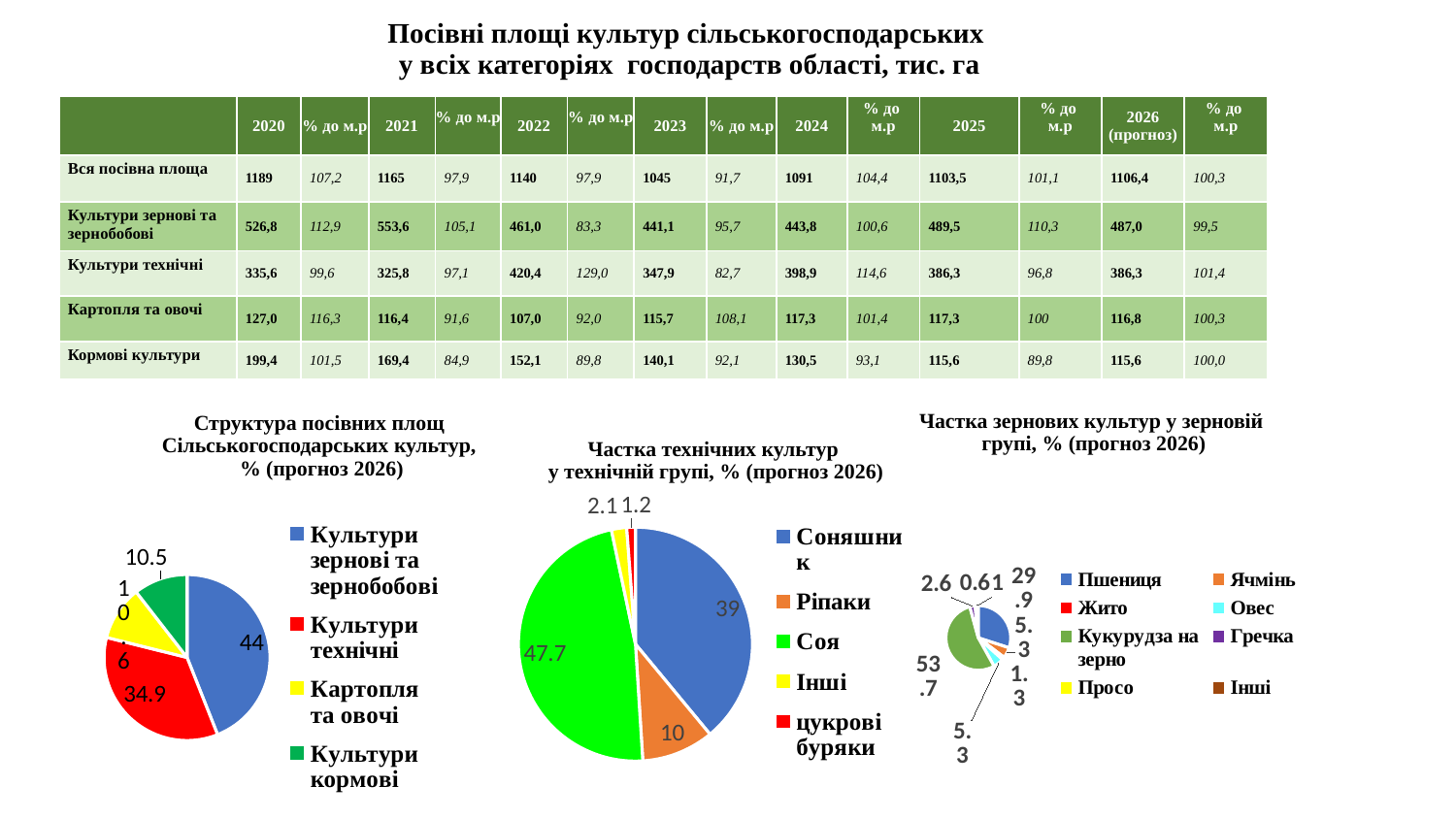
How many entries does the legend of the pie chart 'Структура посівних площ Сільськогосподарських культур, % (прогноз 2026)' list? 4 What type of chart is used for 'Частка зернових культур у зерновій групі, % (прогноз 2026)'? Pie chart In the pie chart 'Структура посівних площ Сільськогосподарських культур, % (прогноз 2026)', what is the value for Культури технічні? 34.9 In the pie chart 'Частка технічних культур у технічній групі, % (прогноз 2026)', what is the value for Соя? 47.7 In the pie chart 'Частка технічних культур у технічній групі, % (прогноз 2026)', what is the difference between the values for Соя and Соняшник? 8.7 In the pie chart 'Частка зернових культур у зерновій групі, % (прогноз 2026)', what is the value for Кукурудза на зерно? 53.7 In the pie chart 'Частка технічних культур у технічній групі, % (прогноз 2026)', what is the value for Ріпаки? 10 In the pie chart 'Структура посівних площ Сільськогосподарських культур, % (прогноз 2026)', what is the share for Культури зернові та зернобобові? 44 In the pie chart 'Частка технічних культур у технічній групі, % (прогноз 2026)', which category has the smallest share? цукрові буряки In the pie chart 'Структура посівних площ Сільськогосподарських культур, % (прогноз 2026)', which category has the largest share? Культури зернові та зернобобові In the pie chart 'Частка технічних культур у технічній групі, % (прогноз 2026)', what is the value for Соняшник? 39 In the pie chart 'Частка зернових культур у зерновій групі, % (прогноз 2026)', which category has the largest share? Кукурудза на зерно